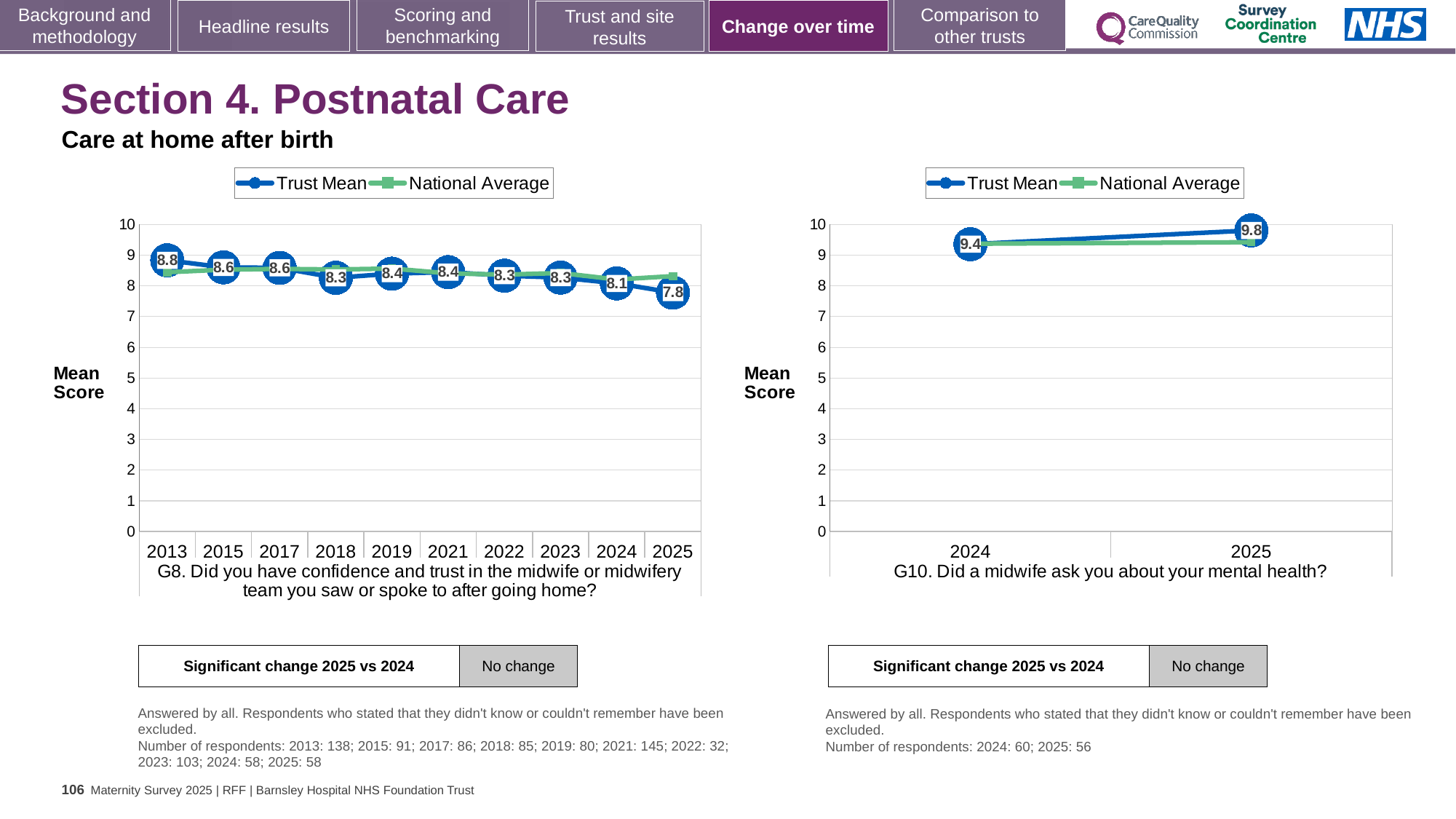
In the G8 chart on the left, does the Trust Mean generally rise or fall from 2013 to 2025? fall What kind of chart is the G8 chart on the left? line chart In the G8 chart on the left, how many years are shown on the x axis? 10 In the G8 chart on the left, which year has the lowest Trust Mean score? 2025 In the G8 chart on the left, what is the Trust Mean score for 2013? 8.8 In the G10 chart on the right, what is the Trust Mean score for 2024? 9.4 In the G10 chart on the right, is the Trust Mean score for 2025 greater or less than 9? greater In the G10 chart on the right, what is the Trust Mean score for 2025? 9.8 In the G8 chart on the left, which year has the highest Trust Mean score? 2013 In the G8 chart on the left, what is the difference between the Trust Mean scores for 2013 and 2025? 1.0 How many series does the legend of the G10 chart on the right list? 2 In the G8 chart on the left, what is the Trust Mean score for 2025? 7.8